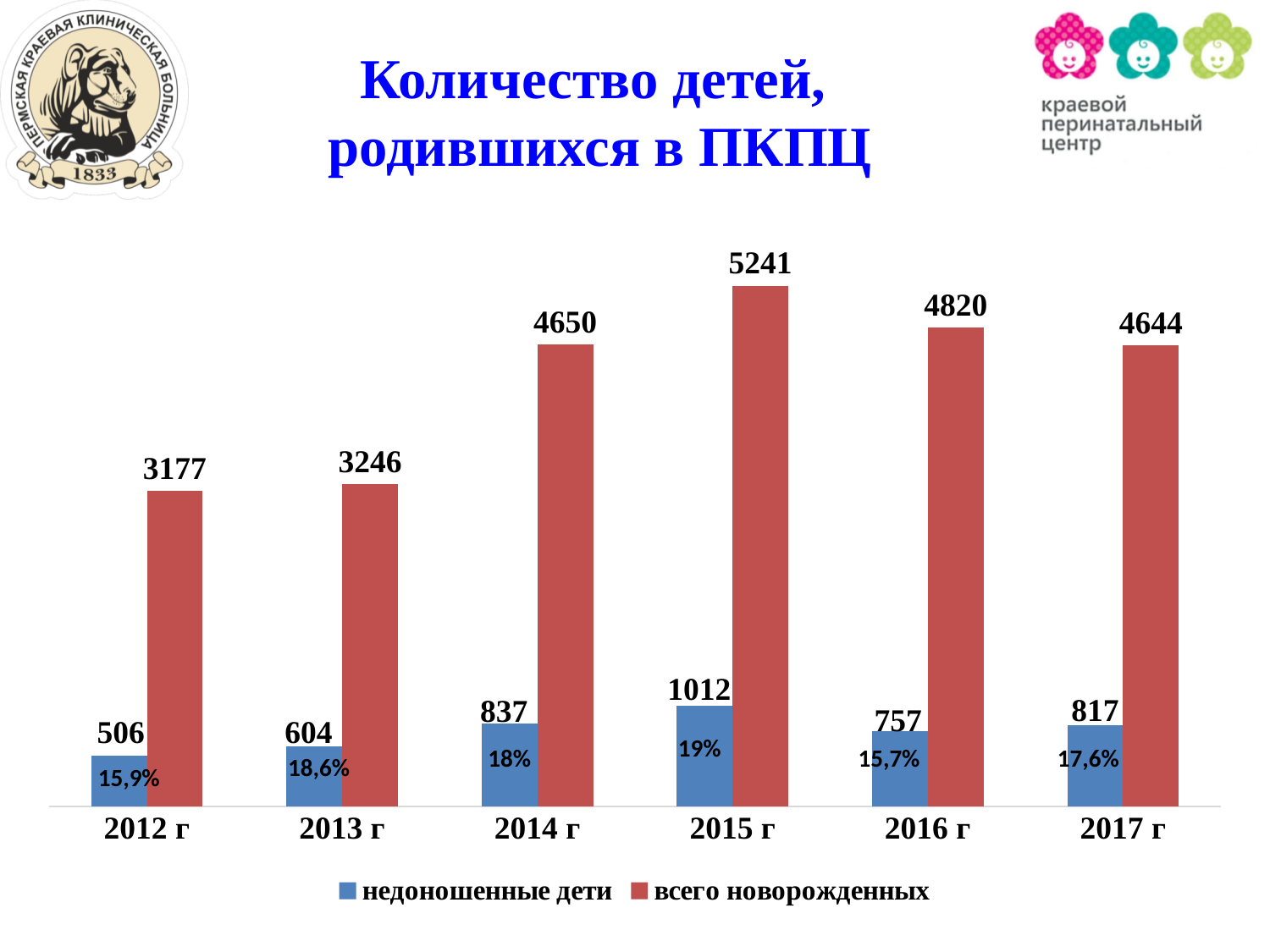
What is the value for всего новорожденных in 2015 г? 5241 What percentage label is shown on the недоношенные дети bar for 2013 г? 18,6% How many series does the legend list? 2 Which year has the highest value for всего новорожденных? 2015 г Which year has the lowest value for недоношенные дети? 2012 г How many years are shown on the x axis? 6 What colour are the bars for всего новорожденных? red Which is larger: недоношенные дети in 2014 г or in 2017 г? 2014 г Does the value for всего новорожденных rise or fall from 2012 г to 2015 г? rise What is the difference between всего новорожденных in 2016 г and 2017 г? 176 What is the value for недоношенные дети in 2012 г? 506 What kind of chart is shown on the slide? bar chart